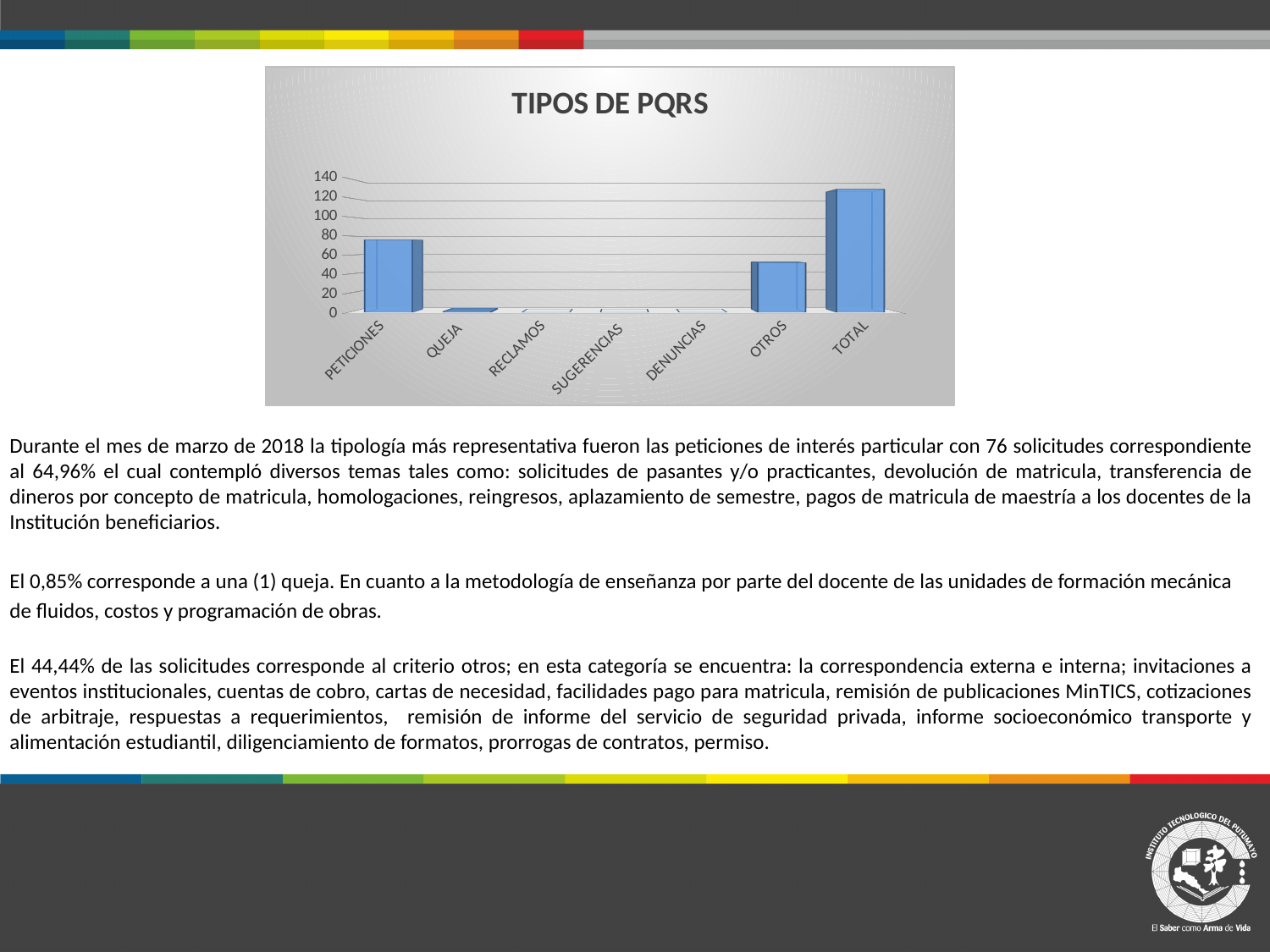
Is the value for PETICIONES greater or less than 60? greater What is the title of the chart? TIPOS DE PQRS Is the value for PETICIONES greater or less than 100? less Which category has the highest bar in the chart? TOTAL Which is larger, the value for PETICIONES or the value for OTROS? PETICIONES How many categories are shown on the x axis of the chart? 7 Which is larger, the value for OTROS or the value for QUEJA? OTROS Is the value for OTROS greater or less than 40? greater What is the highest value shown on the vertical axis of the chart? 140 What kind of chart is shown on the slide? bar chart